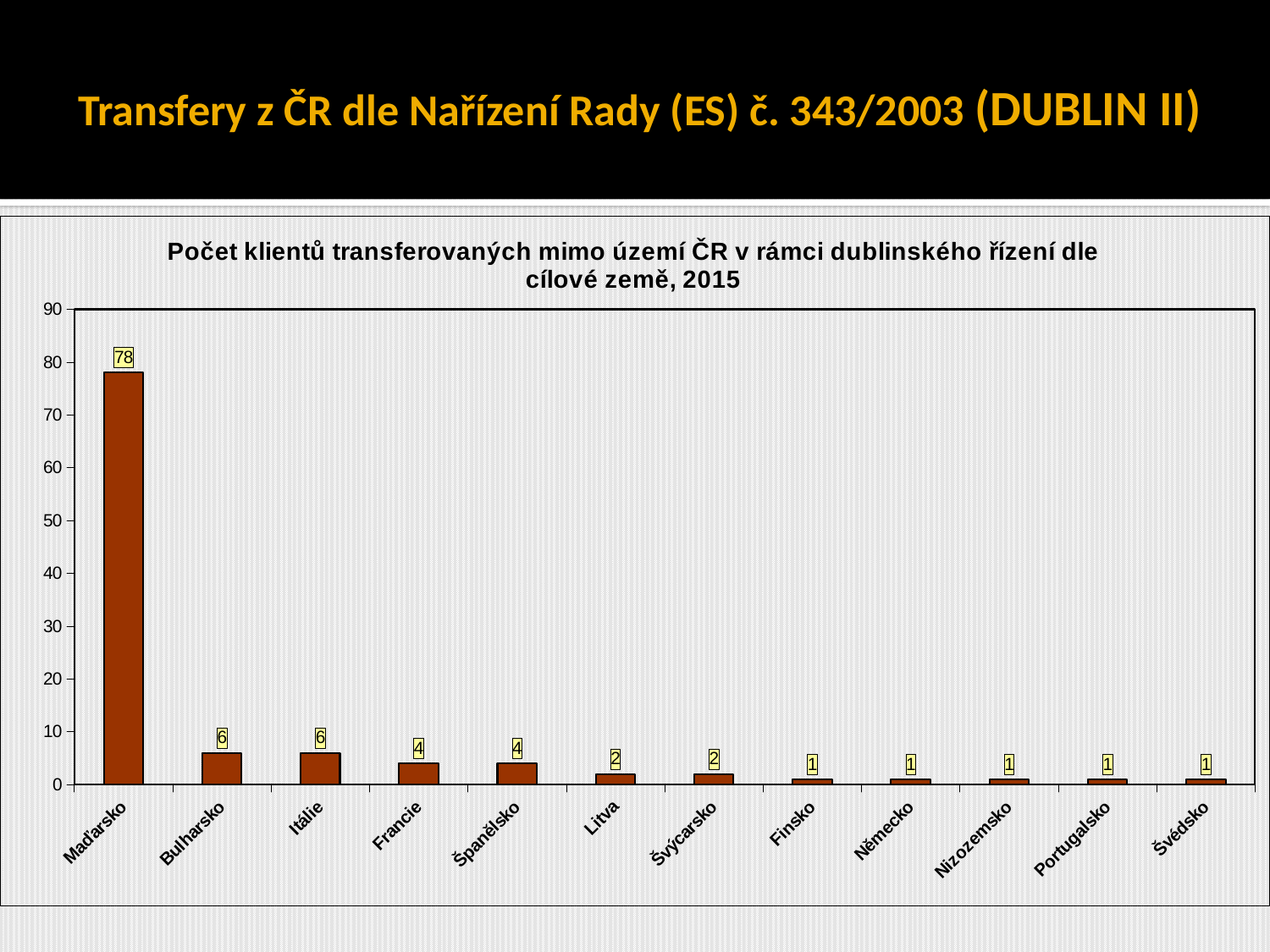
What kind of chart is this? bar chart What is the value for Německo? 1 Which is larger, the value for Itálie or the value for Španělsko? Itálie What is the value for Litva? 2 Do the values rise or fall from left to right along the x axis? fall What is the difference between the values for Maďarsko and Bulharsko? 72 What is the value for Francie? 4 Which country has the highest value? Maďarsko What is the value for Maďarsko? 78 What is the title of the chart? Počet klientů transferovaných mimo území ČR v rámci dublinského řízení dle cílové země, 2015 How many countries are shown on the x axis? 12 Is the value for Maďarsko greater or less than 70? greater